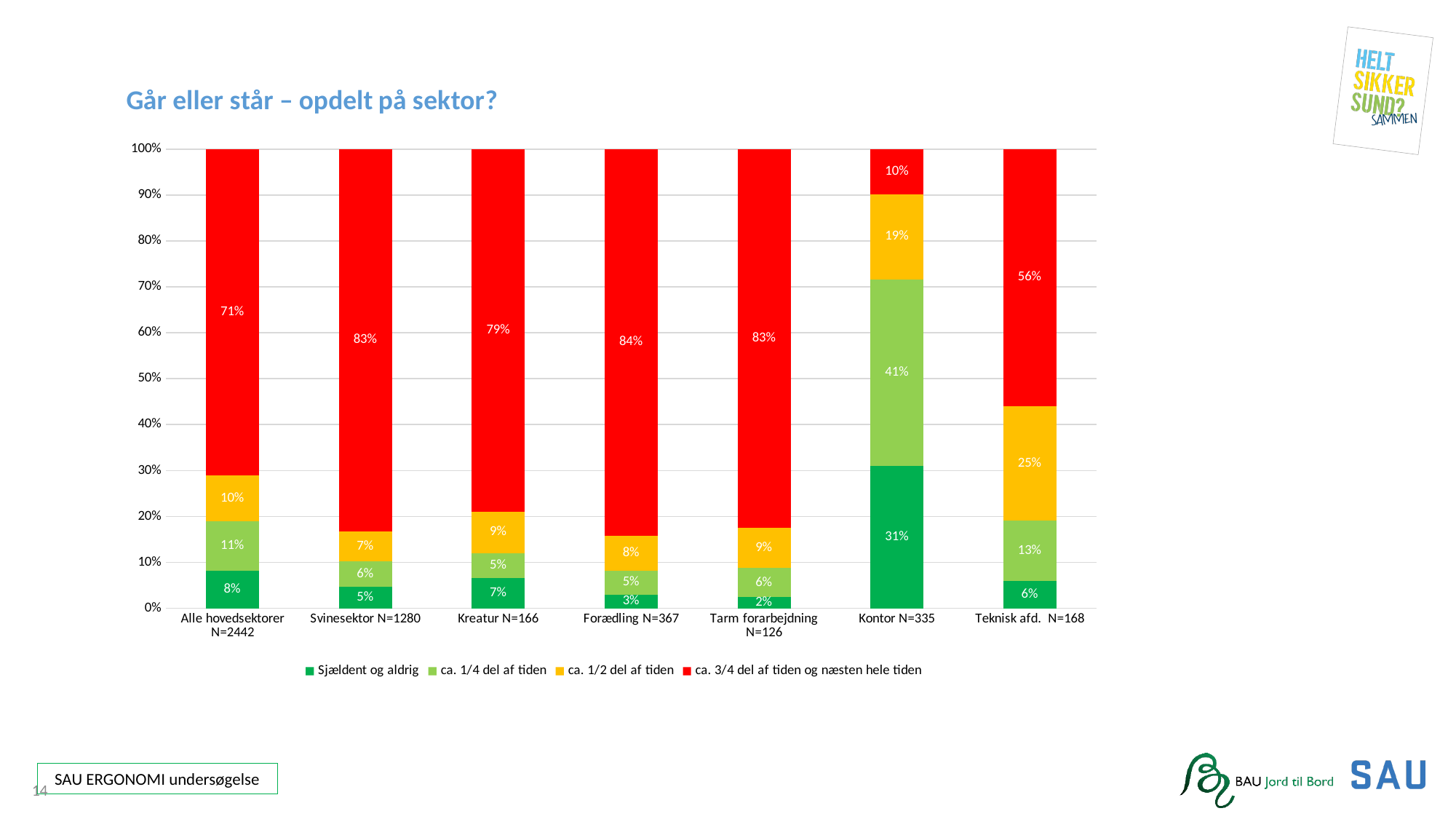
What is the title of the chart? Går eller står – opdelt på sektor? Which colour represents 'ca. 3/4 del af tiden og næsten hele tiden' in the chart? Red Which sector has the highest 'ca. 3/4 del af tiden og næsten hele tiden' share? Forædling N=367 Which sector has the lowest 'Sjældent og aldrig' share? Tarm forarbejdning N=126 What is the 'ca. 1/2 del af tiden' value for Kreatur N=166? 9% What type of chart is shown on the slide? Stacked bar chart What percentage of 'Alle hovedsektorer N=2442' falls in the 'ca. 3/4 del af tiden og næsten hele tiden' category? 71% What is the 'Sjældent og aldrig' value for Kontor N=335? 31% How many series does the legend list? 4 How many sectors (categories) are shown on the x axis? 7 Which has the larger 'ca. 1/2 del af tiden' share: Teknisk afd. N=168 or Kontor N=335? Teknisk afd. N=168 How many percentage points higher is the 'ca. 1/4 del af tiden' share for Kontor N=335 than for Teknisk afd. N=168? 28 percentage points